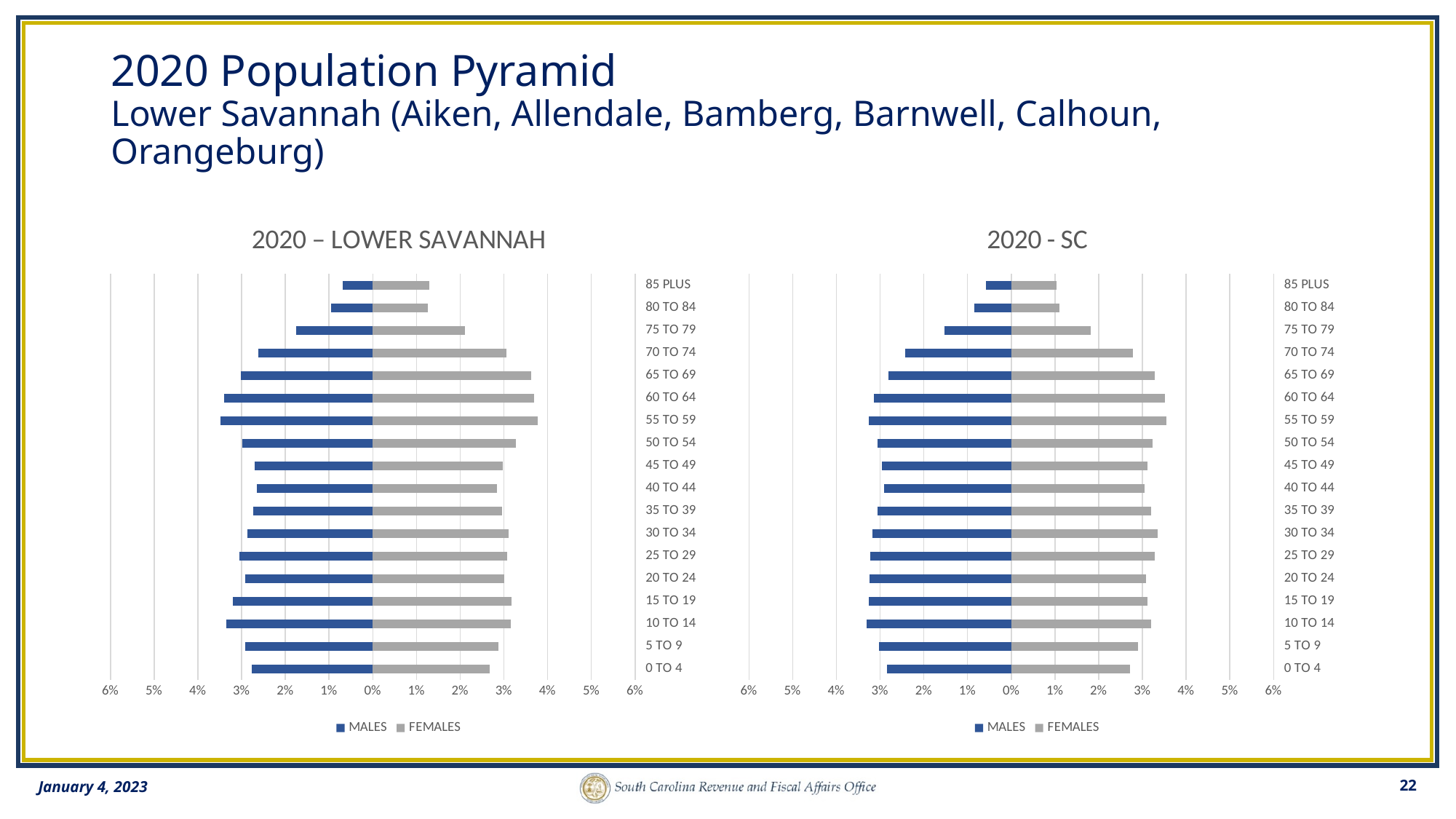
In the 2020 – LOWER SAVANNAH chart, is the MALES value for 85 PLUS greater or less than 1%? less How many age groups are shown on the 2020 - SC chart? 18 What kind of chart is the 2020 – LOWER SAVANNAH chart? Bar chart In the 2020 – LOWER SAVANNAH chart, is the FEMALES value for 55 TO 59 greater or less than 3%? greater How many series does the legend of the 2020 – LOWER SAVANNAH chart list? 2 In the 2020 - SC chart, is the FEMALES value for 75 TO 79 greater or less than 2%? less What are the two legend entries on the 2020 - SC chart? MALES and FEMALES In the 2020 - SC chart, which MALES value is larger: 0 TO 4 or 55 TO 59? 55 TO 59 In the 2020 – LOWER SAVANNAH chart, which age group has the smallest MALES value? 85 PLUS In the 2020 – LOWER SAVANNAH chart, for the 85 PLUS age group, which is larger: the MALES value or the FEMALES value? FEMALES